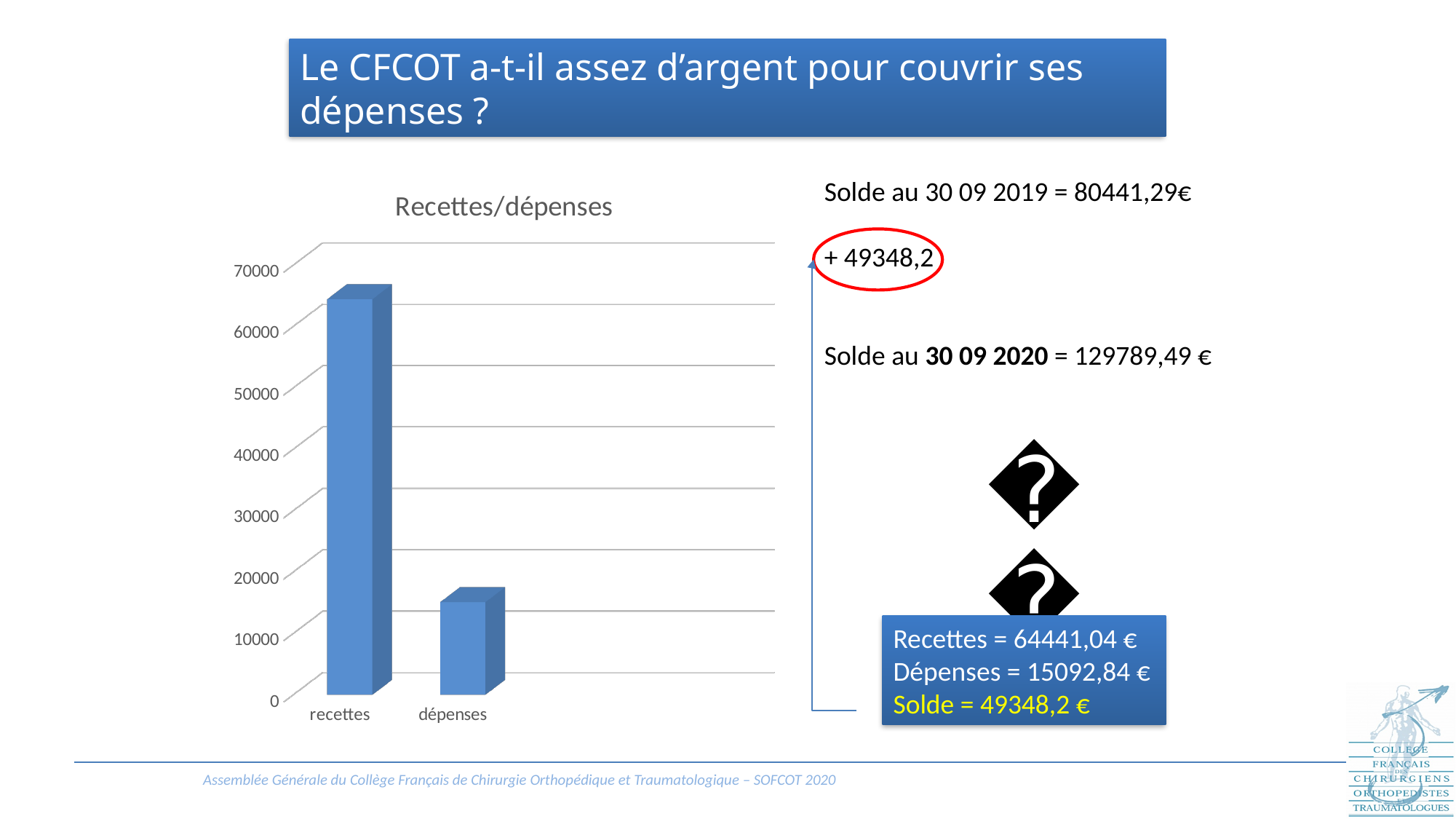
What is the title of the chart? Recettes/dépenses Is the value for dépenses greater or less than 20000? less Which category has the lowest bar in the chart? dépenses Which is larger, recettes or dépenses? recettes What is the highest tick value shown on the vertical axis of the chart? 70000 What kind of chart is shown on the slide? bar chart According to the text box on the slide, what is the value of Dépenses? 15092,84 € Which category has the highest bar in the chart? recettes According to the text box on the slide, what is the value of Recettes? 64441,04 € Is the value for recettes greater or less than 60000? greater What is the difference between Recettes and Dépenses (the Solde) as printed on the slide? 49348,2 € How many categories are plotted in the chart? 2